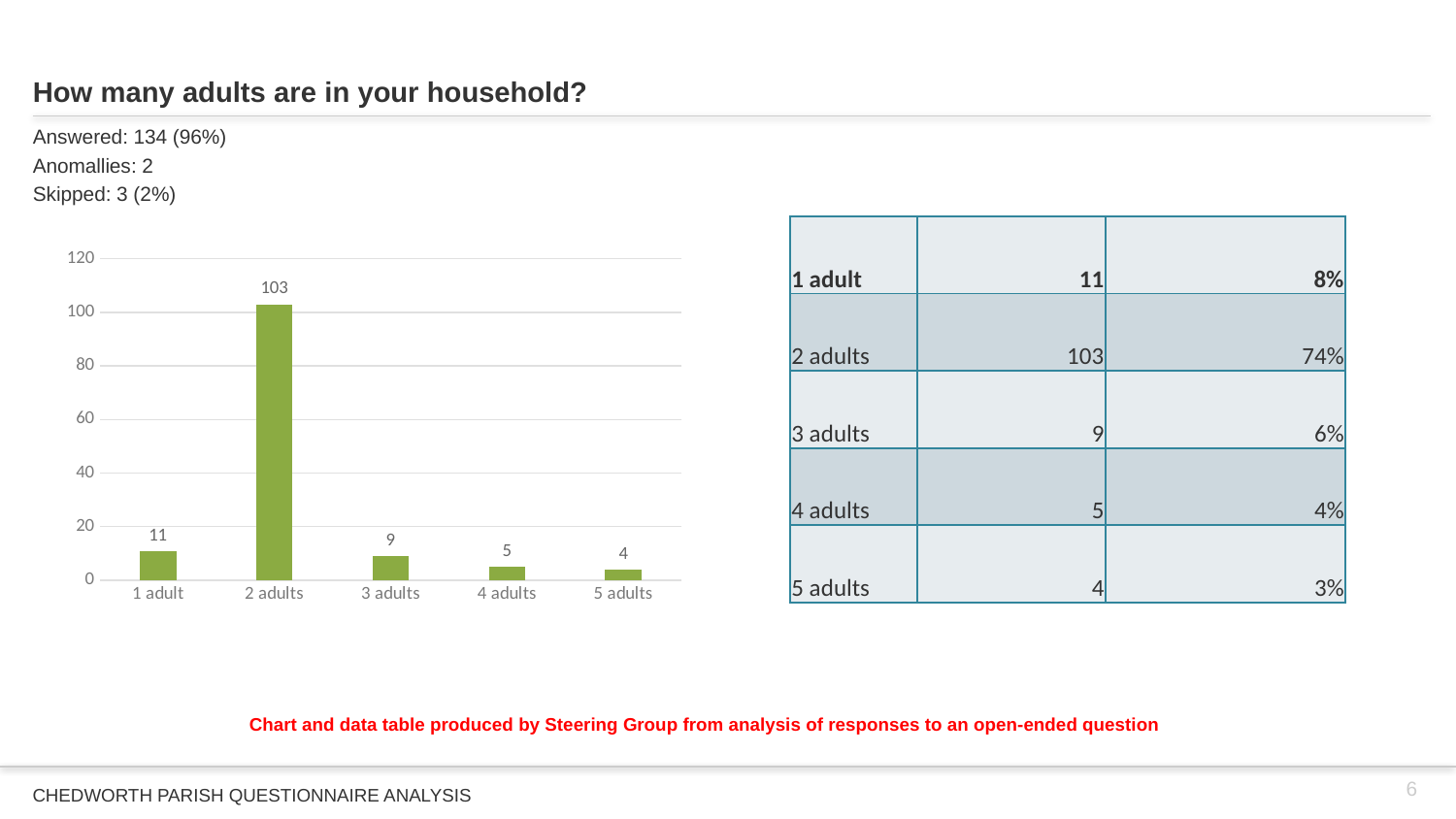
What is the value for 2 adults? 103 Is the value for 2 adults greater or less than 100? greater What is the difference between the values for 3 adults and 4 adults? 4 Which is larger, the value for 1 adult or the value for 3 adults? 1 adult What is the difference between the values for 2 adults and 1 adult? 92 Which category has the highest value? 2 adults What colour are the bars in the chart? green How many categories are shown on the x axis? 5 What is the value for 1 adult? 11 What is the value for 5 adults? 4 What kind of chart is shown on the slide? bar chart Which category has the lowest value? 5 adults